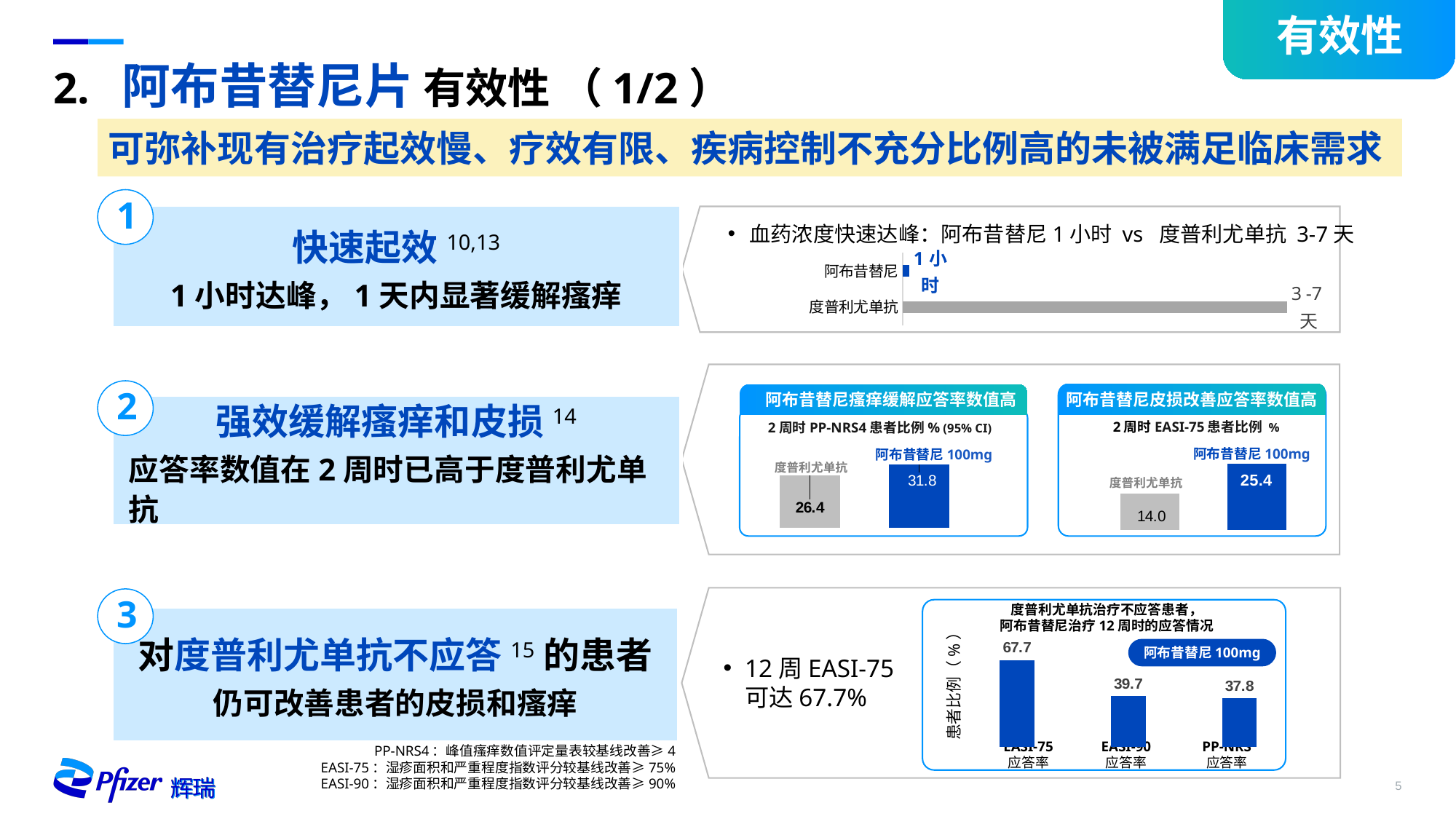
In the bottom-right chart (度普利尤单抗治疗不应答患者，阿布昔替尼治疗12周时的应答情况), which category has the lowest value? PP-NRS 应答率 In the bottom-right chart (度普利尤单抗治疗不应答患者，阿布昔替尼治疗12周时的应答情况), how many bars are shown? 3 In the chart titled 阿布昔替尼瘙痒缓解应答率数值高, what is the difference between the 阿布昔替尼 100mg and 度普利尤单抗 values? 5.4 In the chart titled 阿布昔替尼瘙痒缓解应答率数值高, what is the value for 阿布昔替尼 100mg? 31.8 In the chart titled 阿布昔替尼皮损改善应答率数值高, which bar is higher, 阿布昔替尼 100mg or 度普利尤单抗? 阿布昔替尼 100mg In the chart titled 阿布昔替尼皮损改善应答率数值高, what is the difference between the 阿布昔替尼 100mg and 度普利尤单抗 values? 11.4 What kind of chart is the bottom-right chart (度普利尤单抗治疗不应答患者，阿布昔替尼治疗12周时的应答情况)? Bar chart In the bottom-right chart (度普利尤单抗治疗不应答患者，阿布昔替尼治疗12周时的应答情况), what is the value for EASI-75 应答率? 67.7 In the chart titled 阿布昔替尼皮损改善应答率数值高, what is the value for 度普利尤单抗? 14.0 In the chart titled 阿布昔替尼皮损改善应答率数值高, what is the value for 阿布昔替尼 100mg? 25.4 In the chart titled 阿布昔替尼瘙痒缓解应答率数值高, what is the value for 度普利尤单抗? 26.4 In the bottom-right chart (度普利尤单抗治疗不应答患者，阿布昔替尼治疗12周时的应答情况), what is the value for EASI-90 应答率? 39.7